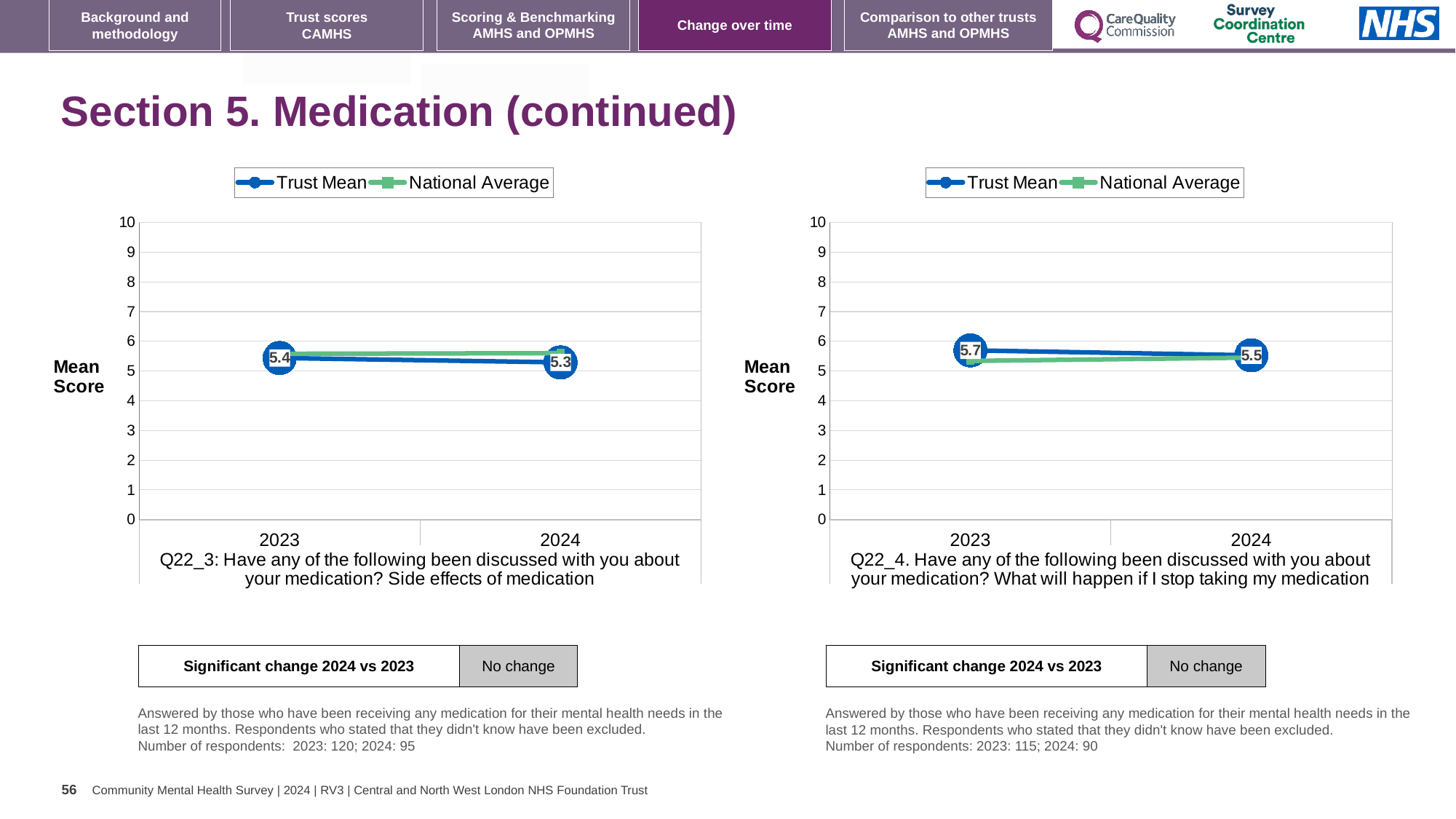
What kind of chart is the left chart (Q22_3)? line chart How many years are shown on the x axis of the left chart (Q22_3)? 2 In the left chart (Q22_3), what is the Trust Mean for 2023? 5.4 In the right chart (Q22_4), what is the Trust Mean for 2023? 5.7 In the left chart (Q22_3), what is the Trust Mean for 2024? 5.3 In the right chart (Q22_4), what is the difference between the Trust Mean for 2023 and 2024? 0.2 In the right chart (Q22_4), what is the Trust Mean for 2024? 5.5 In the right chart (Q22_4), which year has the higher Trust Mean, 2023 or 2024? 2023 In the left chart (Q22_3), is the National Average for 2024 greater or less than 7? less What is the y-axis label on the right chart (Q22_4)? Mean Score In the left chart (Q22_3), does the Trust Mean rise or fall from 2023 to 2024? fall How many series does the legend of the right chart (Q22_4) list? 2